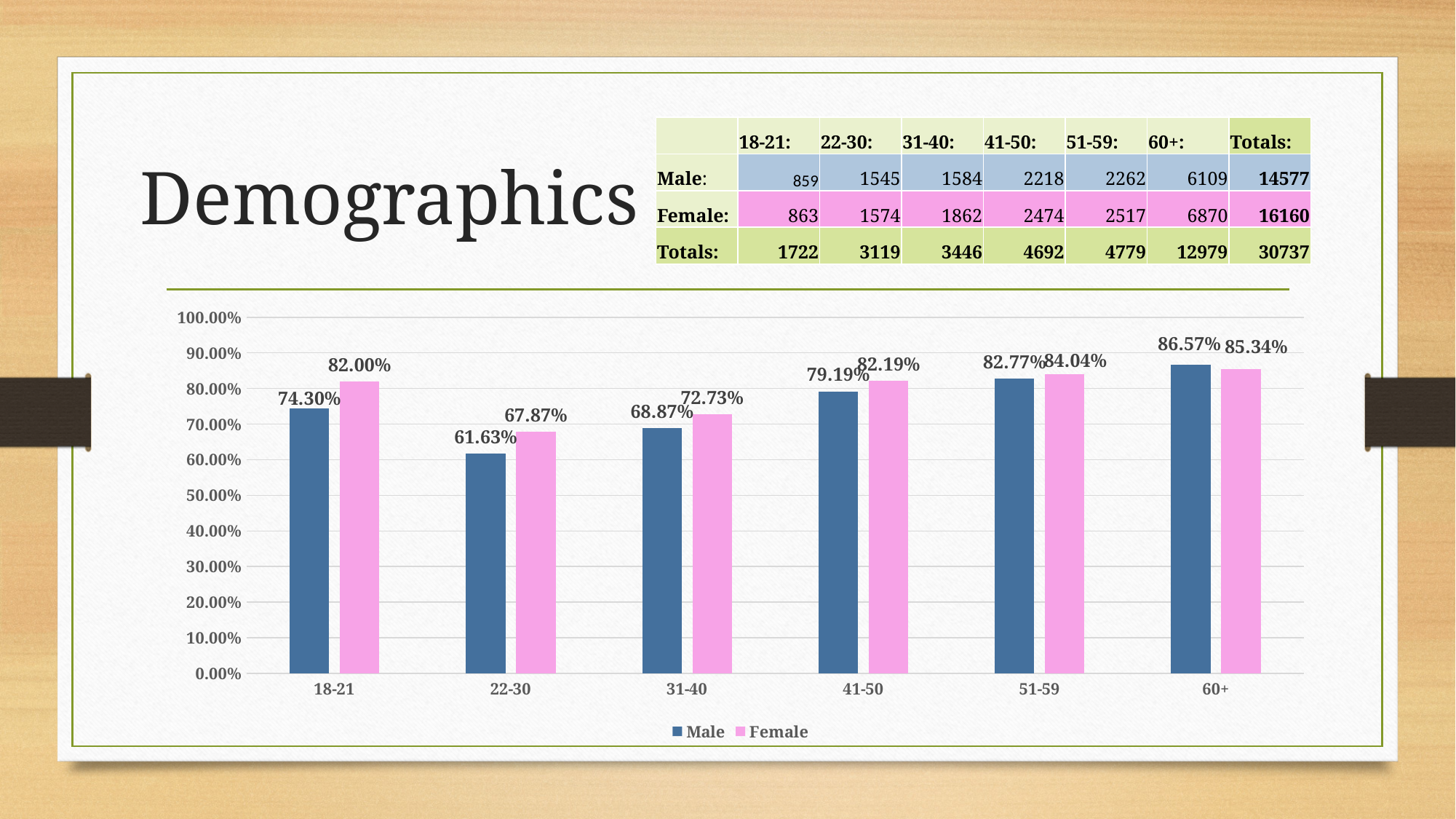
How many series does the chart legend list? 2 How many age groups are shown on the x axis of the chart? 6 Which age group has the lowest Male value? 22-30 What is the Male value for the 60+ age group? 86.57% What is the Male value for the 18-21 age group? 74.30% What is the Female value for the 41-50 age group? 82.19% What is the difference between the Female and Male values for the 18-21 age group? 7.70% What is the Female value for the 22-30 age group? 67.87% What kind of chart is shown on the slide? Bar chart Which is larger for the 60+ age group, the Male value or the Female value? Male Which age group has the highest Female value? 60+ Is the Male value for the 31-40 age group greater or less than 70.00%? less